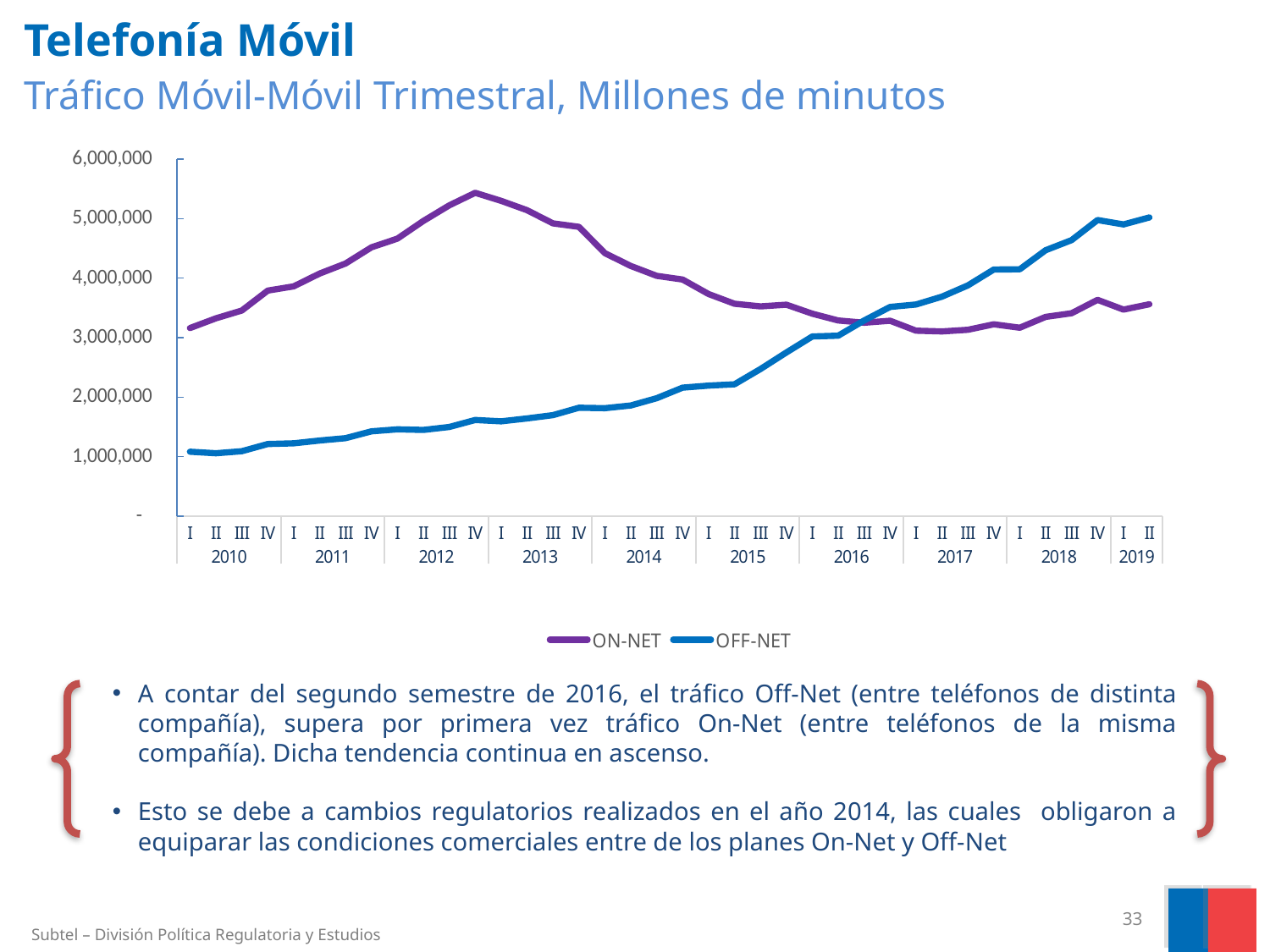
Is the ON-NET value in quarter IV of 2012 greater or less than 5,000,000? greater How many series does the legend list? 2 What kind of chart is shown on the slide? Line chart What is the title of the chart? Tráfico Móvil-Móvil Trimestral, Millones de minutos Is the ON-NET value in quarter II of 2019 greater or less than 4,000,000? less Is the OFF-NET value in quarter I of 2010 greater or less than 2,000,000? less What are the two series named in the legend? ON-NET and OFF-NET In quarter I of 2010, which series has the larger value, ON-NET or OFF-NET? ON-NET In quarter II of 2019, which series has the larger value, ON-NET or OFF-NET? OFF-NET In which quarter does the ON-NET series reach its highest value? IV 2012 How many quarterly data points are plotted for each series? 38